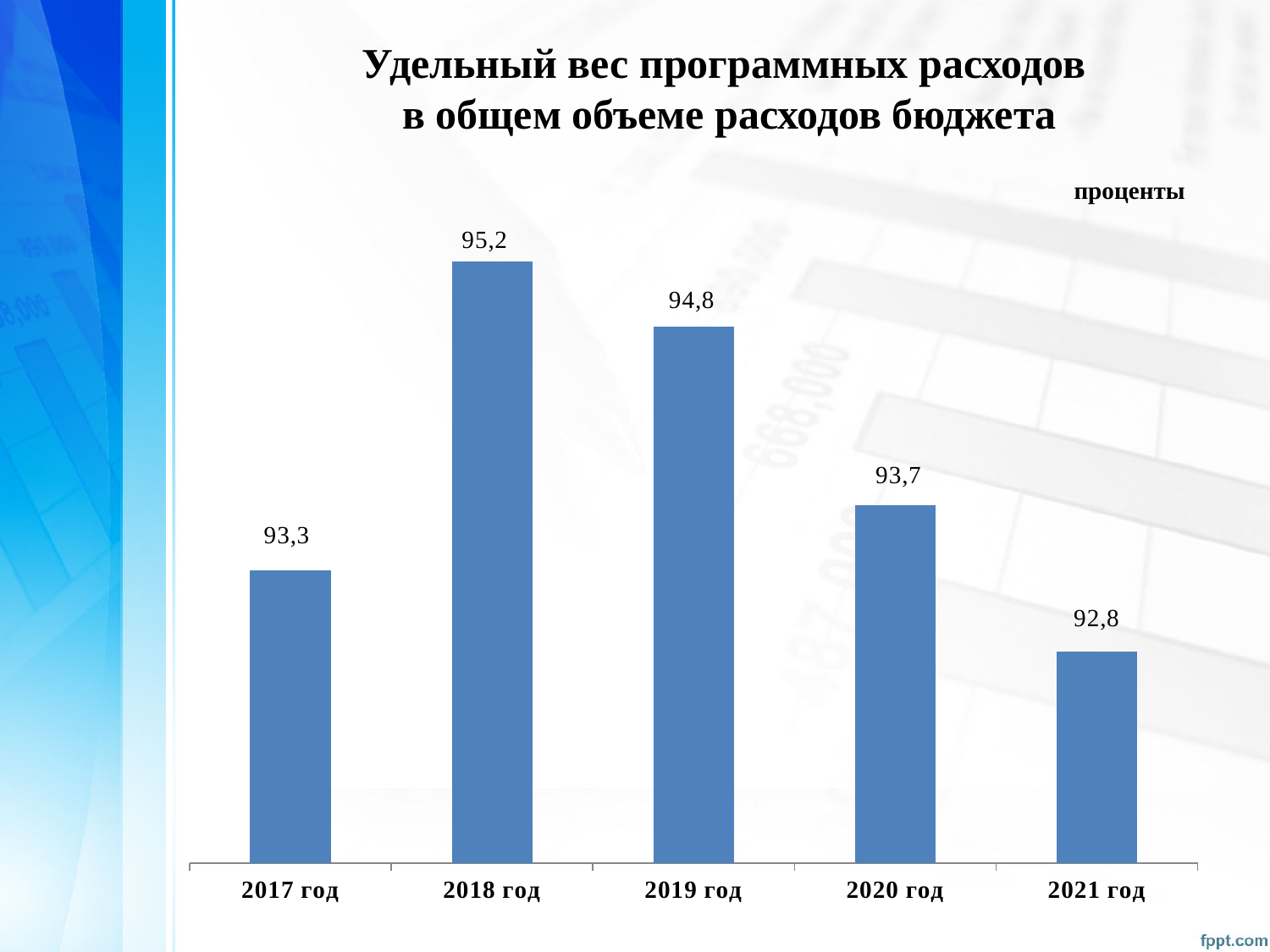
What is the value for 2018 год? 95,2 What is the value for 2021 год? 92,8 What kind of chart is shown on the slide? bar chart Which year has the highest value? 2018 год What is the difference between the values for 2018 год and 2021 год? 2,4 How many years are shown on the chart? 5 Do the values rise or fall from 2018 год to 2021 год? fall What is the difference between the values for 2019 год and 2020 год? 1,1 What unit is indicated above the chart? проценты Which year has the lowest value? 2021 год What is the value for 2017 год? 93,3 Which is larger, the value for 2017 год or the value for 2020 год? 2020 год